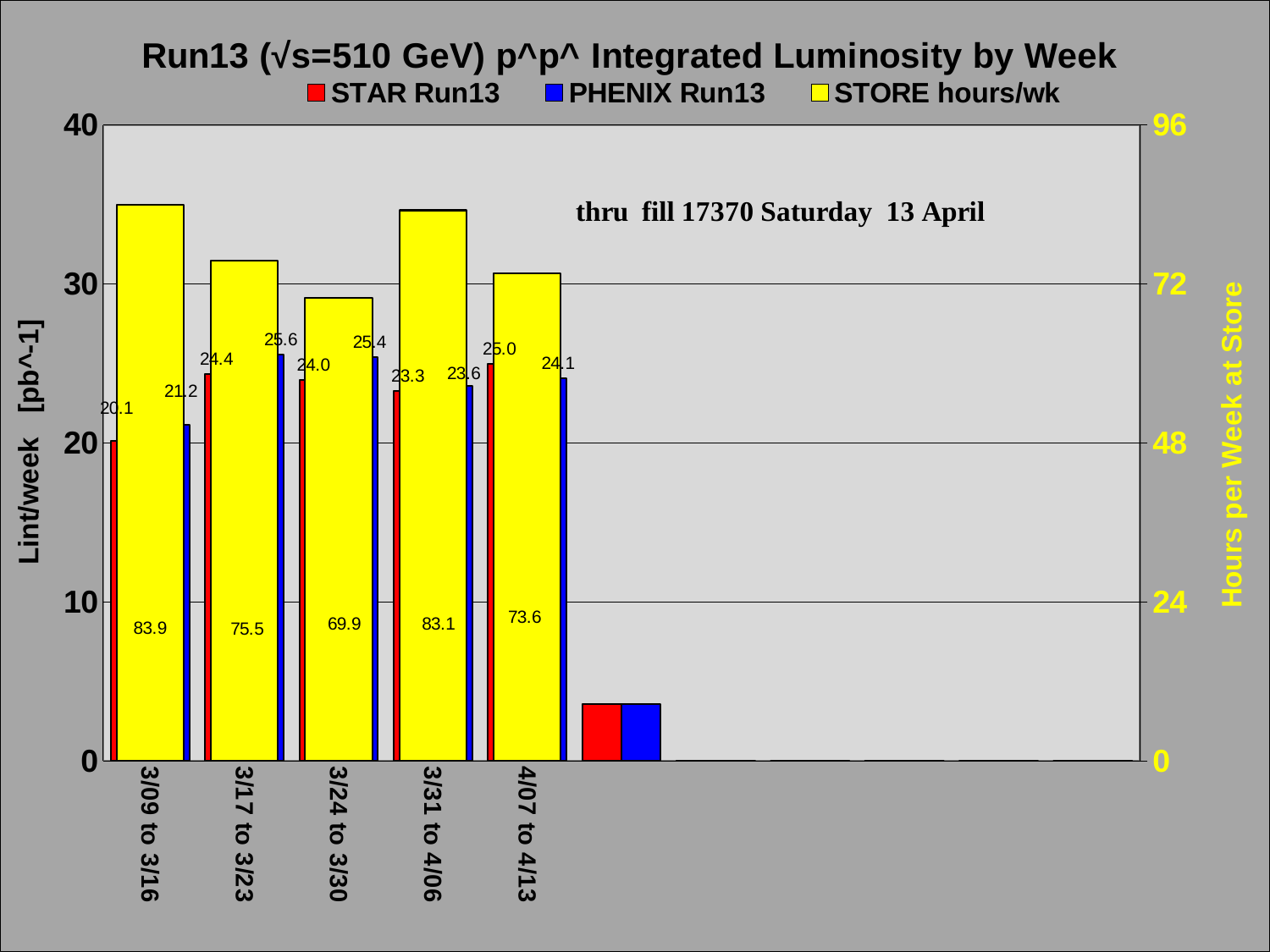
For the week 3/09 to 3/16, which is larger: the STAR Run13 value or the PHENIX Run13 value? PHENIX Run13 What kind of chart is shown on the slide? Bar chart What is the STAR Run13 value for the week 4/07 to 4/13? 25.0 What is the label of the right-hand vertical axis? Hours per Week at Store What is the STORE hours/wk value for the week 3/24 to 3/30? 69.9 Which week has the highest PHENIX Run13 value? 3/17 to 3/23 What is the STAR Run13 value for the week 3/09 to 3/16? 20.1 Which week has the highest STORE hours/wk value? 3/09 to 3/16 What is the difference between the highest and lowest STORE hours/wk values (83.9 and 69.9)? 14.0 How many series does the legend list? 3 Which week has the lowest STAR Run13 value? 3/09 to 3/16 What is the PHENIX Run13 value for the week 3/17 to 3/23? 25.6